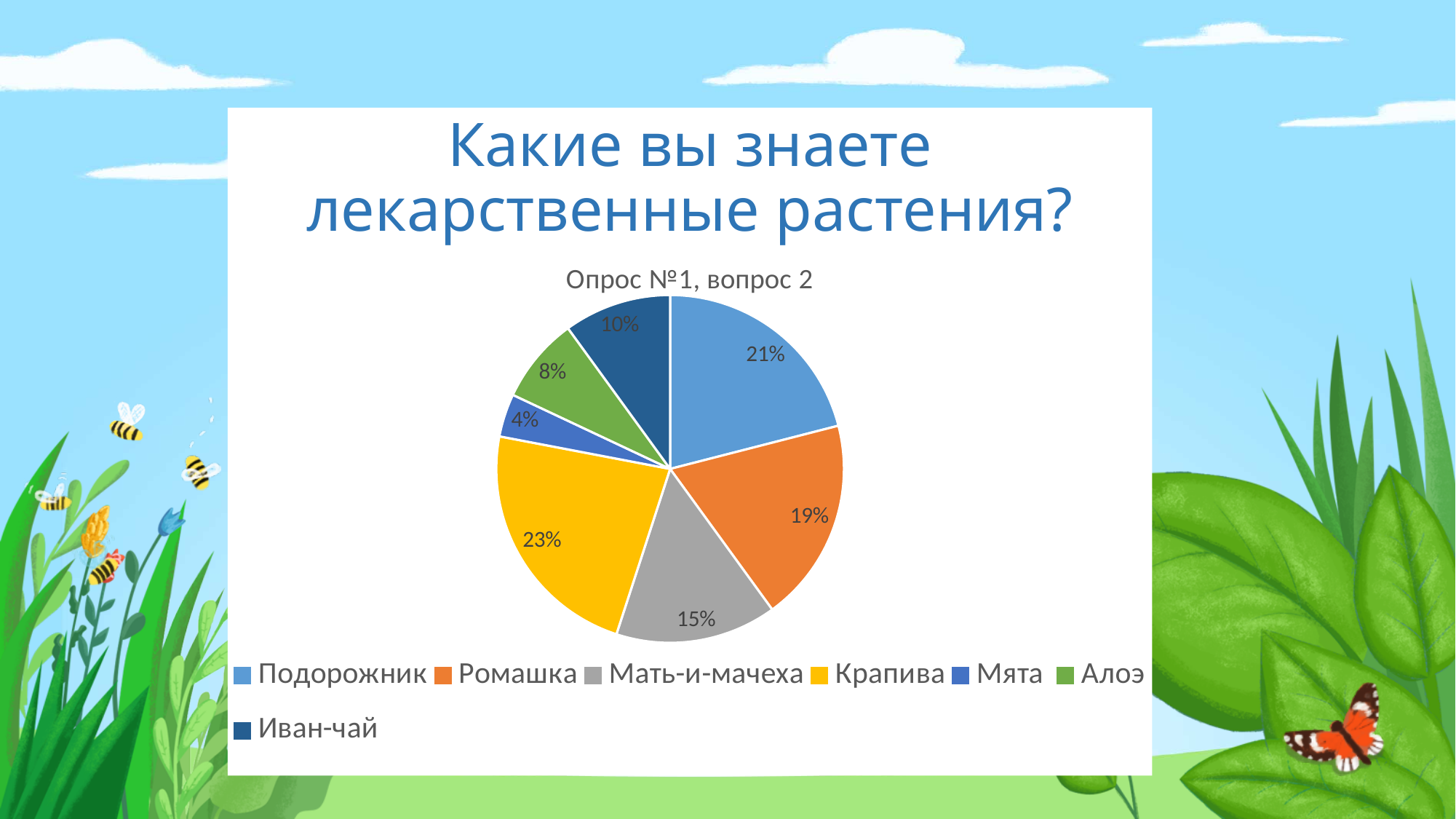
What is the difference between the shares of Ромашка and Мать-и-мачеха? 4% What share of the pie does Мята have? 4% What share of the pie does Крапива have? 23% What colour is the Крапива slice? yellow Which category has the smallest slice of the pie? Мята How many categories does the pie chart have? 7 What share of the pie does Подорожник have? 21% What kind of chart is shown on the slide? pie chart Which category has the largest slice of the pie? Крапива Which has a larger share, Алоэ or Иван-чай? Иван-чай What share of the pie does Иван-чай have? 10% What is the chart's title? Опрос №1, вопрос 2